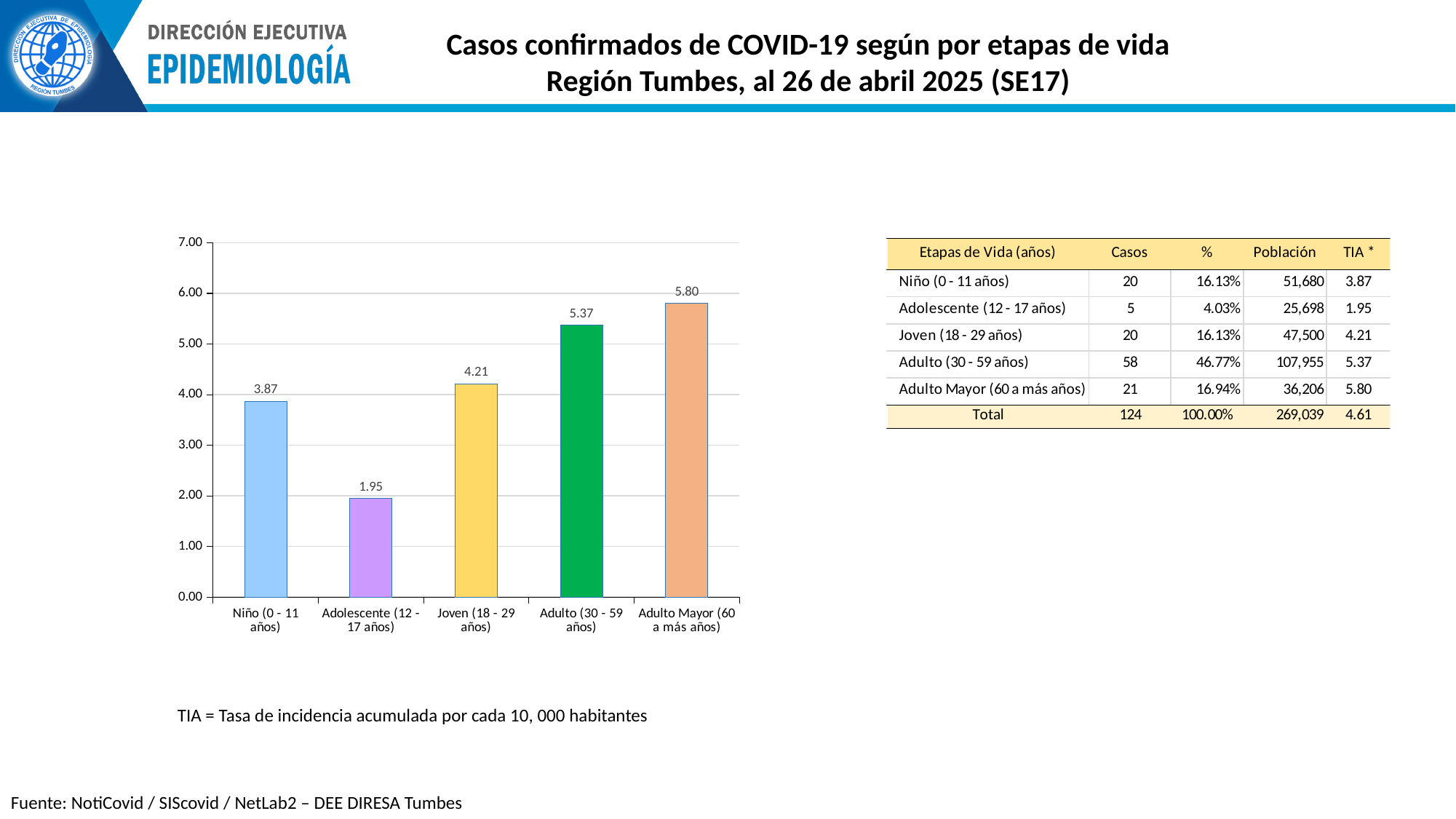
What is the value shown for Niño (0 - 11 años) in the bar chart? 3.87 Is the value for Adulto (30 - 59 años) in the bar chart greater or less than 5.00? greater Which is larger in the bar chart, the value for Niño (0 - 11 años) or the value for Joven (18 - 29 años)? Joven (18 - 29 años) Which category has the lowest value in the bar chart? Adolescente (12 - 17 años) What is the value shown for Adulto Mayor (60 a más años) in the bar chart? 5.80 What is the value shown for Adolescente (12 - 17 años) in the bar chart? 1.95 What is the maximum value shown on the y axis of the bar chart? 7.00 How many categories are shown on the x axis of the bar chart? 5 What is the difference between the values for Adulto (30 - 59 años) and Joven (18 - 29 años) in the bar chart? 1.16 What kind of chart is shown on the slide? bar chart Which category has the highest value in the bar chart? Adulto Mayor (60 a más años) What colour is the bar for Adulto (30 - 59 años) in the bar chart? green